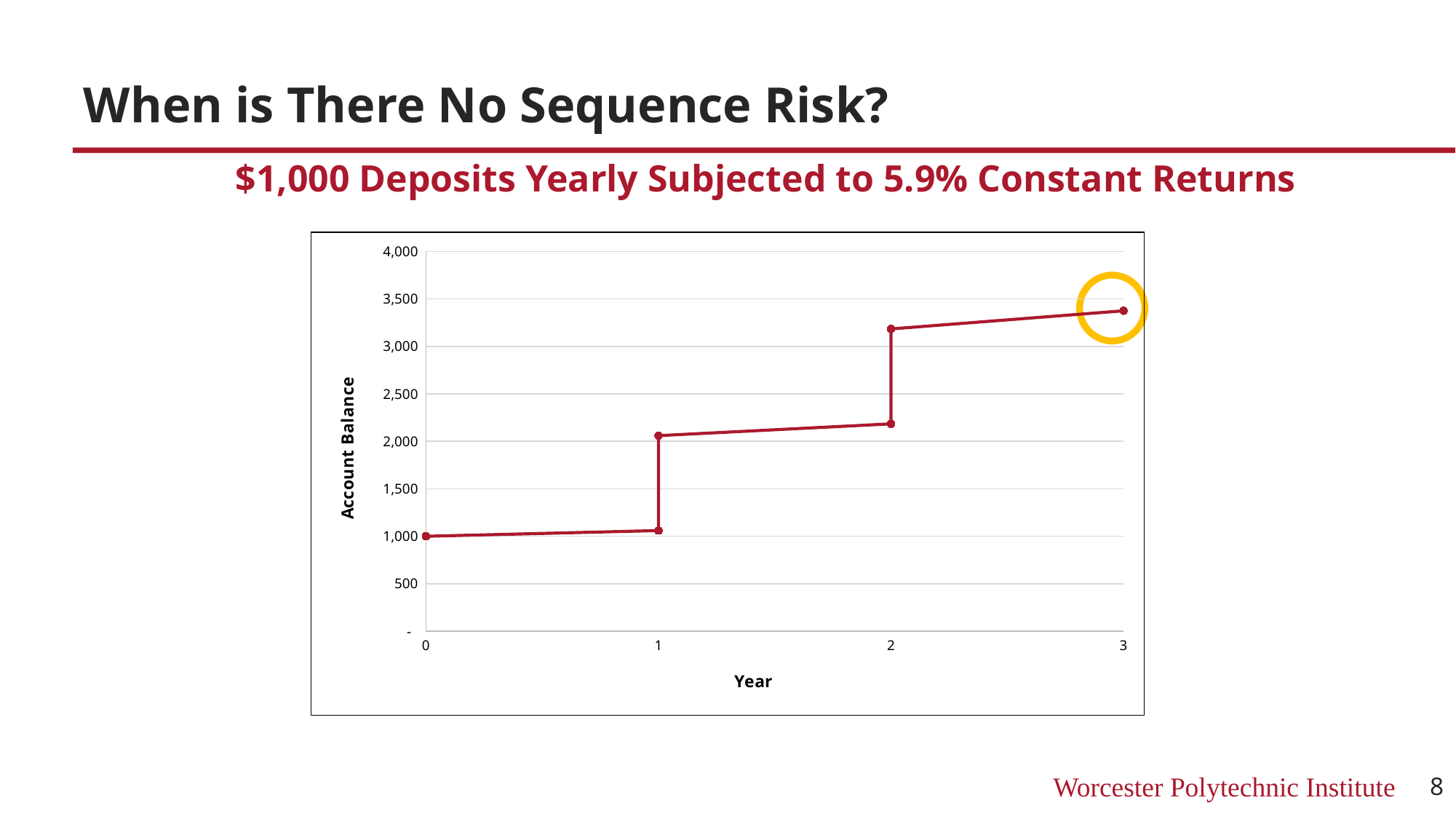
Is the lower of the two points at year 2 greater or less than 2,500? less What is the title of the vertical axis? Account Balance Does the account balance rise or fall as the year increases? rises Is the higher of the two points at year 1 greater or less than 2,000? greater What kind of chart is shown on the slide? line chart Is the account balance at year 3 greater or less than 3,000? greater At which year is the account balance highest? 3 At which year is the account balance lowest? 0 Which is larger: the higher point at year 2 or the higher point at year 1? year 2 How many data points are plotted on the line? 6 What is the account balance at year 0? 1,000